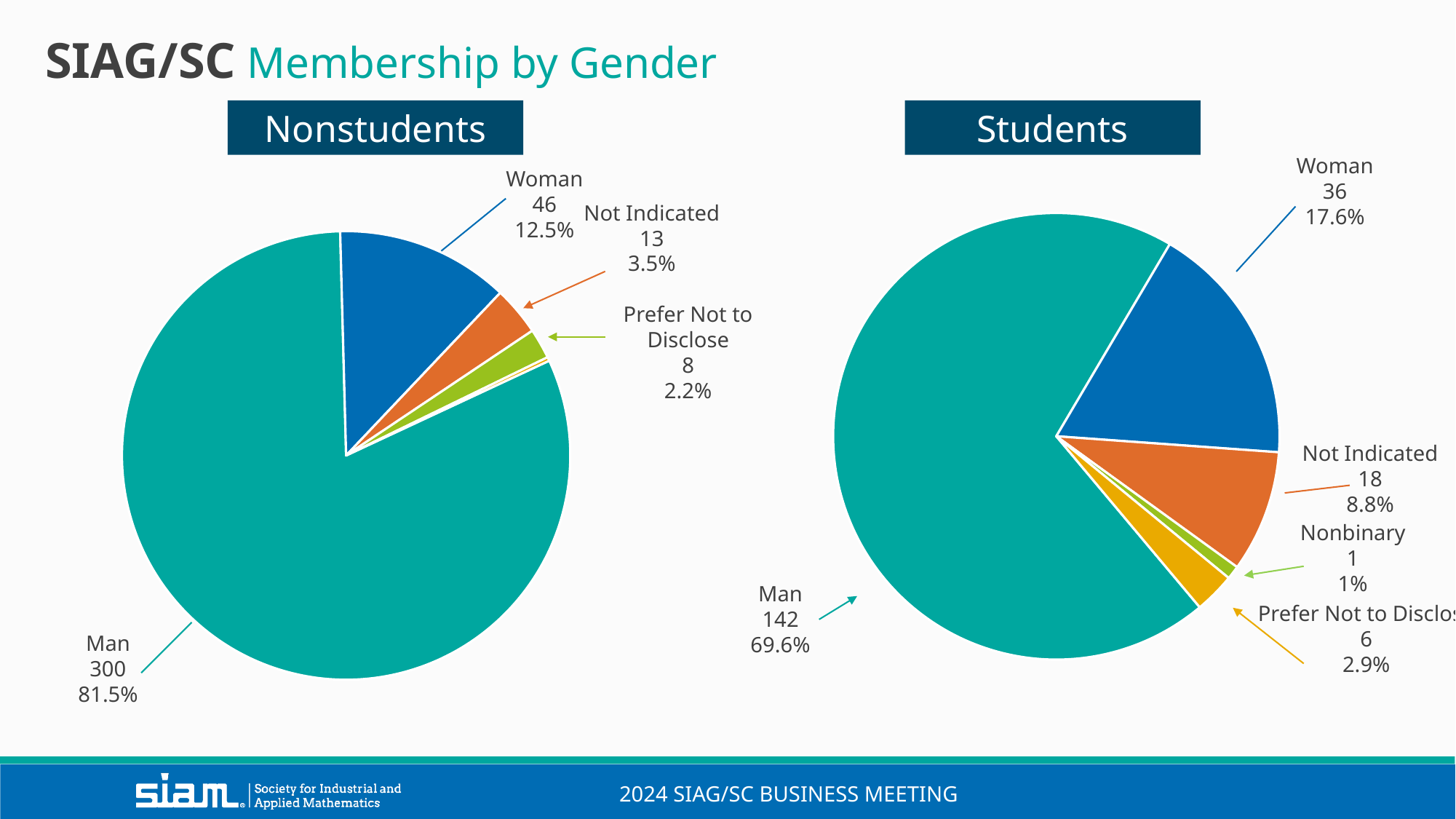
In the Students chart, how many categories are shown in the pie? 5 In the Nonstudents chart, what is the difference between the Not Indicated count and the Prefer Not to Disclose count? 5 What is the title of the slide? SIAG/SC Membership by Gender In the Students chart, what share of the pie is Man? 69.6% What type of chart is used on this slide? Pie chart What is the difference between the number of Woman members in the Nonstudents chart and in the Students chart? 10 In the Nonstudents chart, how many members are labelled Man? 300 In the Students chart, which is larger: Not Indicated or Prefer Not to Disclose? Not Indicated In the Nonstudents chart, which labelled category has the largest slice? Man In the Students chart, how many members are labelled Not Indicated? 18 In the Students chart, which category has the smallest slice? Nonbinary In the Nonstudents chart, what percentage of members are Woman? 12.5%